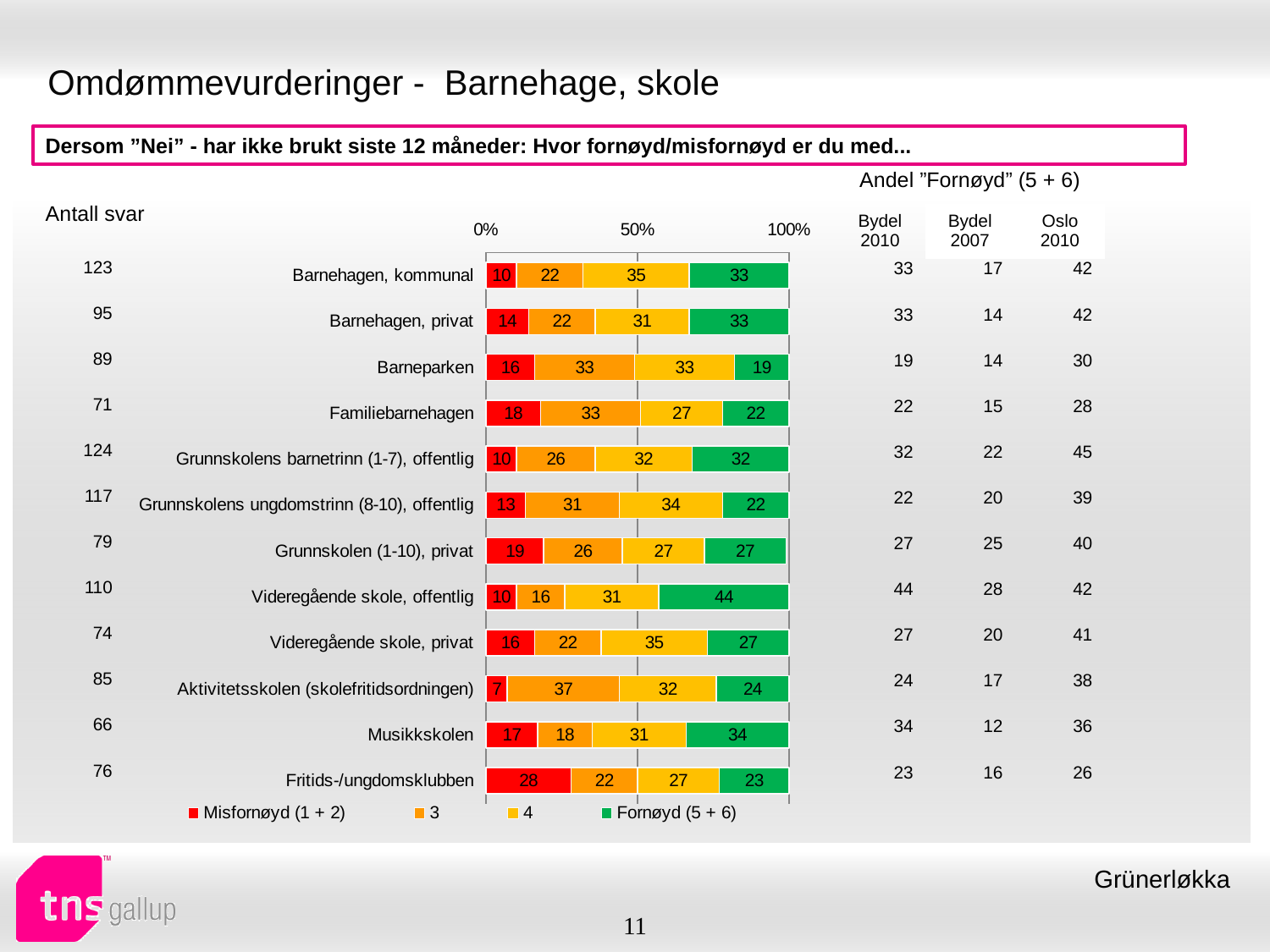
How many categories (services) are plotted in the chart? 12 What is the total of the stacked bar for Barnehagen, kommunal? 100 What is the Misfornøyd (1 + 2) value for Fritids-/ungdomsklubben? 28 Which category has the highest Fornøyd (5 + 6) value? Videregående skole, offentlig Which has a larger Fornøyd (5 + 6) value: Musikkskolen or Familiebarnehagen? Musikkskolen Which category has the lowest Fornøyd (5 + 6) value? Barneparken How many series does the legend list? 4 What type of chart is shown on the slide? stacked bar chart Which category has the lowest Misfornøyd (1 + 2) value? Aktivitetsskolen (skolefritidsordningen) What is the Fornøyd (5 + 6) value for Videregående skole, offentlig? 44 What is the difference between the Fornøyd (5 + 6) values for Videregående skole, offentlig and Barneparken? 25 What is the value of series 3 for Aktivitetsskolen (skolefritidsordningen)? 37